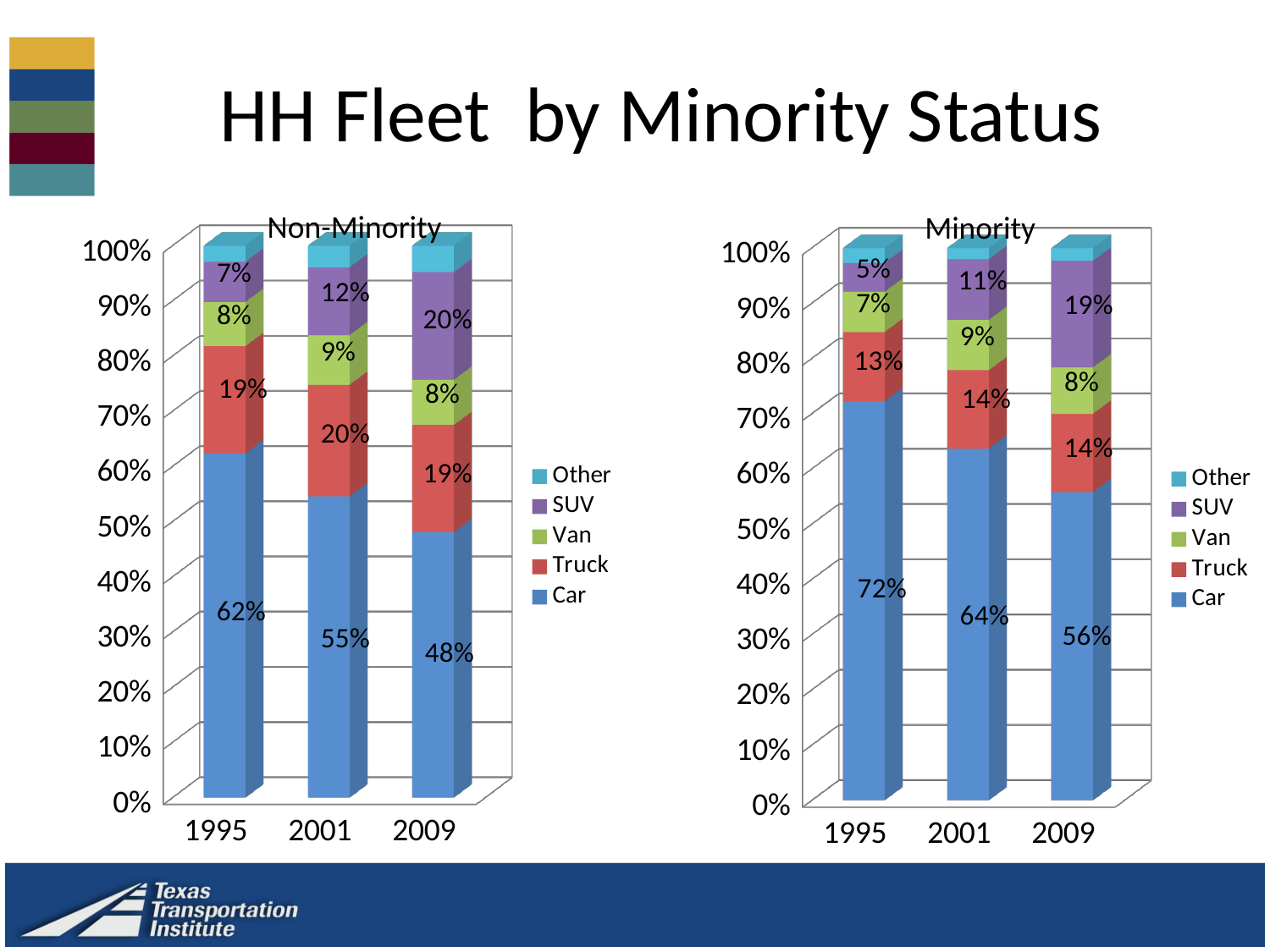
In the Non-Minority chart, what is the Truck share in 2001? 20% Which is larger: the Car share in 2001 in the Non-Minority chart or in the Minority chart? Minority In the Minority chart, what is the Van share in 1995? 7% In the Minority chart, what is the difference between the SUV share in 2009 and in 1995? 14% In the Non-Minority chart, does the Car share rise or fall from 1995 to 2009? fall In the Non-Minority chart, which year has the lowest Car share? 2009 In the Minority chart, which year has the highest Car share? 1995 In the Non-Minority chart, what is the difference between the Car share in 1995 and in 2009? 14% In the Minority chart, what is the SUV share in 2009? 19% In the Non-Minority chart, what is the Car share in 1995? 62% How many series does the legend of the Minority chart list? 5 What kind of chart is the Non-Minority chart? stacked bar chart